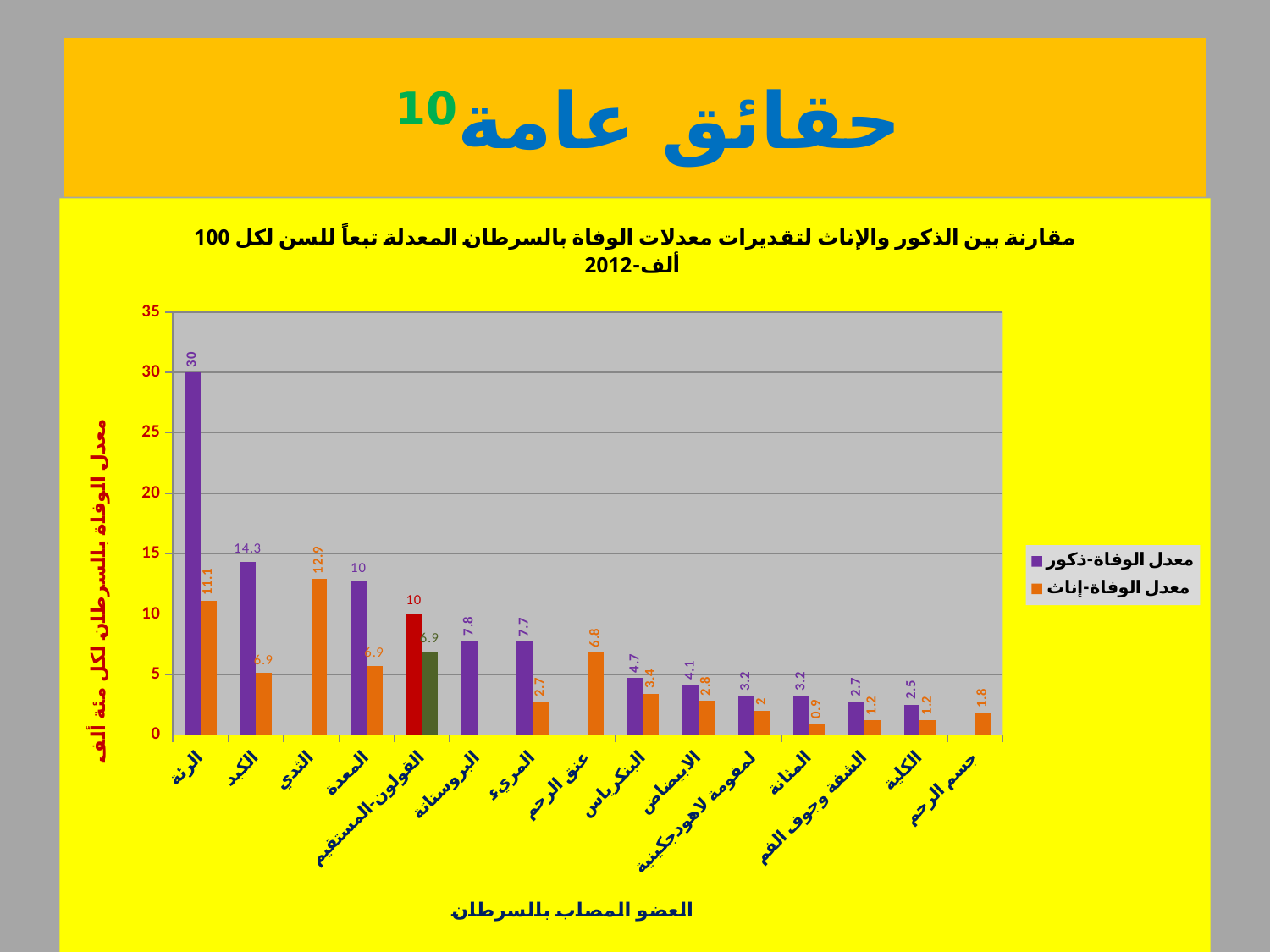
How many categories (organs) are shown on the x axis? 15 Is the male death rate for الكبد greater or less than 10? greater What is the male death rate (معدل الوفاة-ذكور) for البروستاتة? 7.8 Which category has the highest male death rate (معدل الوفاة-ذكور)? الرئة Which category has the lowest female death rate (معدل الوفاة-إناث)? المثانة What is the female death rate (معدل الوفاة-إناث) for الرئة? 11.1 What is the male death rate (معدل الوفاة-ذكور) for الرئة? 30 How many series does the legend list? 2 What type of chart is shown on the slide? bar chart What is the difference between the male and female death rates for الرئة? 18.9 What is the female death rate (معدل الوفاة-إناث) for الثدي? 12.9 Which is larger for المريء: the male death rate or the female death rate? the male death rate